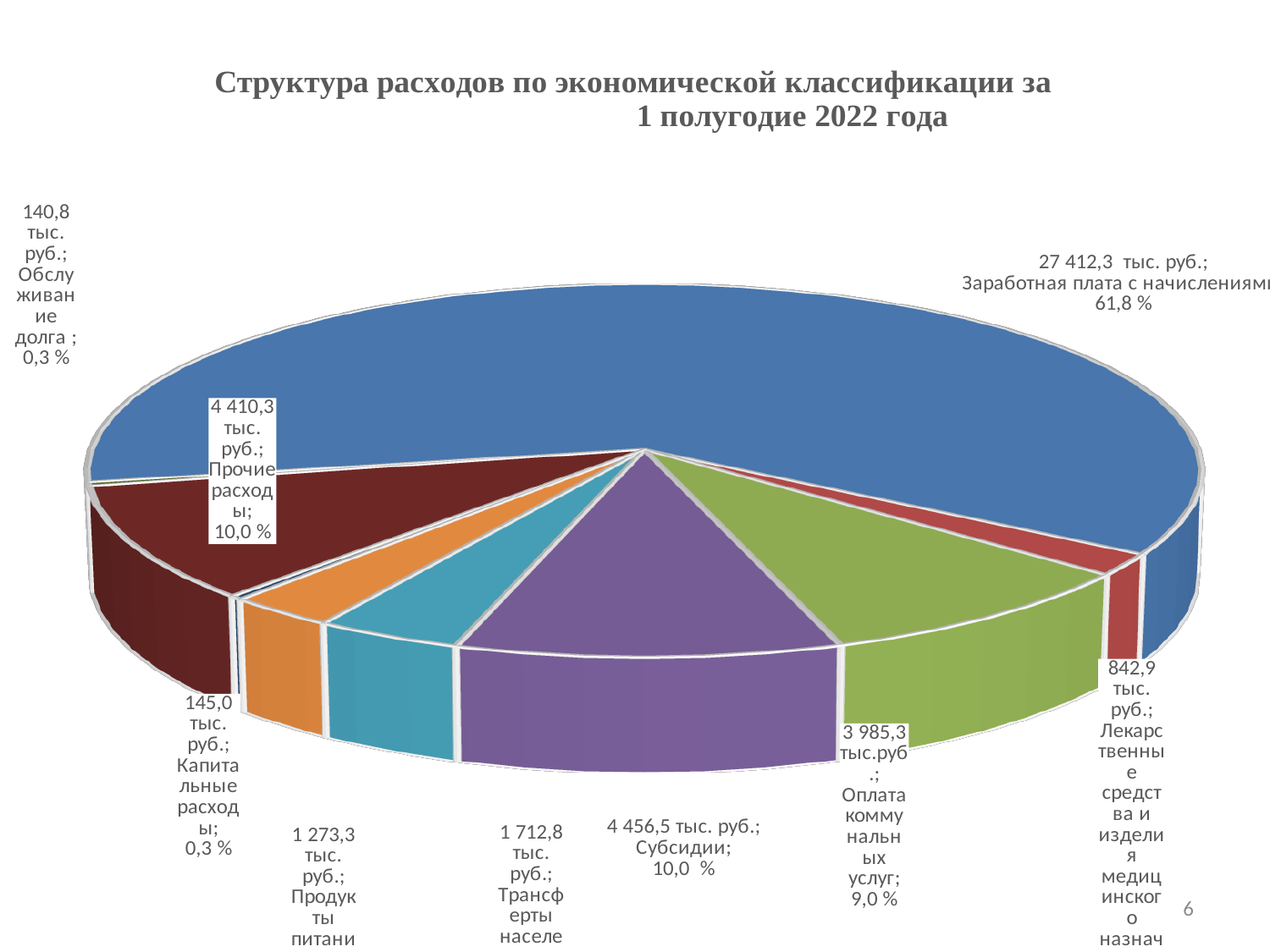
What share of the pie does Оплата коммунальных услуг take? 9,0 % Which category has the smallest value? Обслуживание долга What kind of chart is shown on the slide? pie chart Which category has the largest share of the pie? Заработная плата с начислениями What is the value for Заработная плата с начислениями? 27 412,3 тыс. руб. Which is larger, Субсидии or Прочие расходы? Субсидии What is the value for Субсидии? 4 456,5 тыс. руб. What is the value for Оплата коммунальных услуг? 3 985,3 тыс.руб. What share of the pie does Заработная плата с начислениями take? 61,8 % What is the value for Прочие расходы? 4 410,3 тыс. руб. How many slices does the pie chart have? 9 What is the difference between the values for Субсидии and Оплата коммунальных услуг? 471,2 тыс. руб.